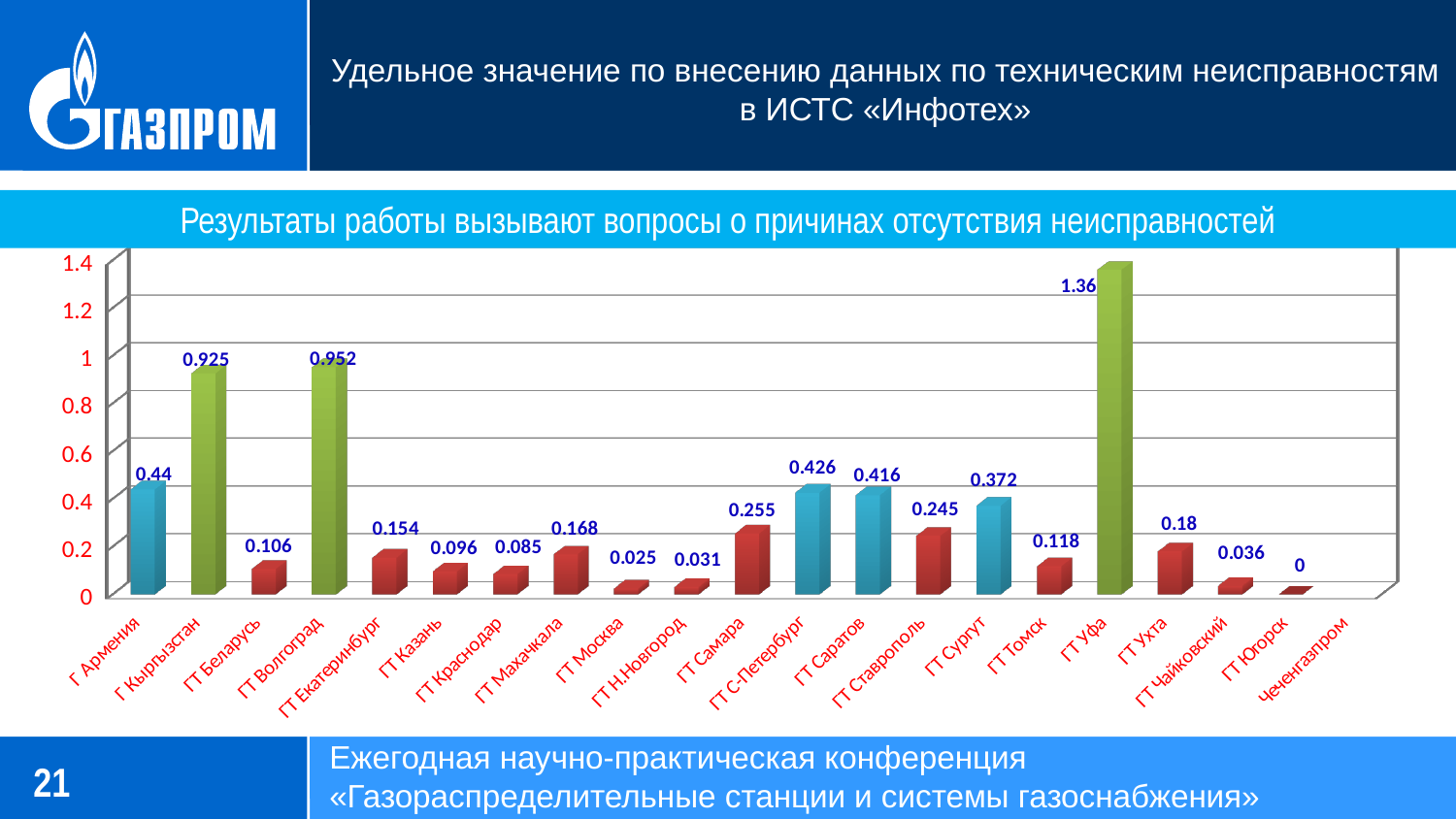
What is the value for ГТ Волгоград? 0.952 How many categories are shown on the x axis? 21 What is the value for ГТ Уфа? 1.36 What is the value for ГТ С-Петербург? 0.426 Which category has the highest value? ГТ Уфа What is the value for Г Армения? 0.44 What is the value for ГТ Томск? 0.118 What is the value for ГТ Москва? 0.025 Which is larger, the value for Г Армения or the value for ГТ Сургут? Г Армения What is the difference between the values for ГТ Волгоград and Г Кыргызстан? 0.027 Is the value for ГТ Уфа greater or less than 1.2? greater What kind of chart is shown on the slide? bar chart